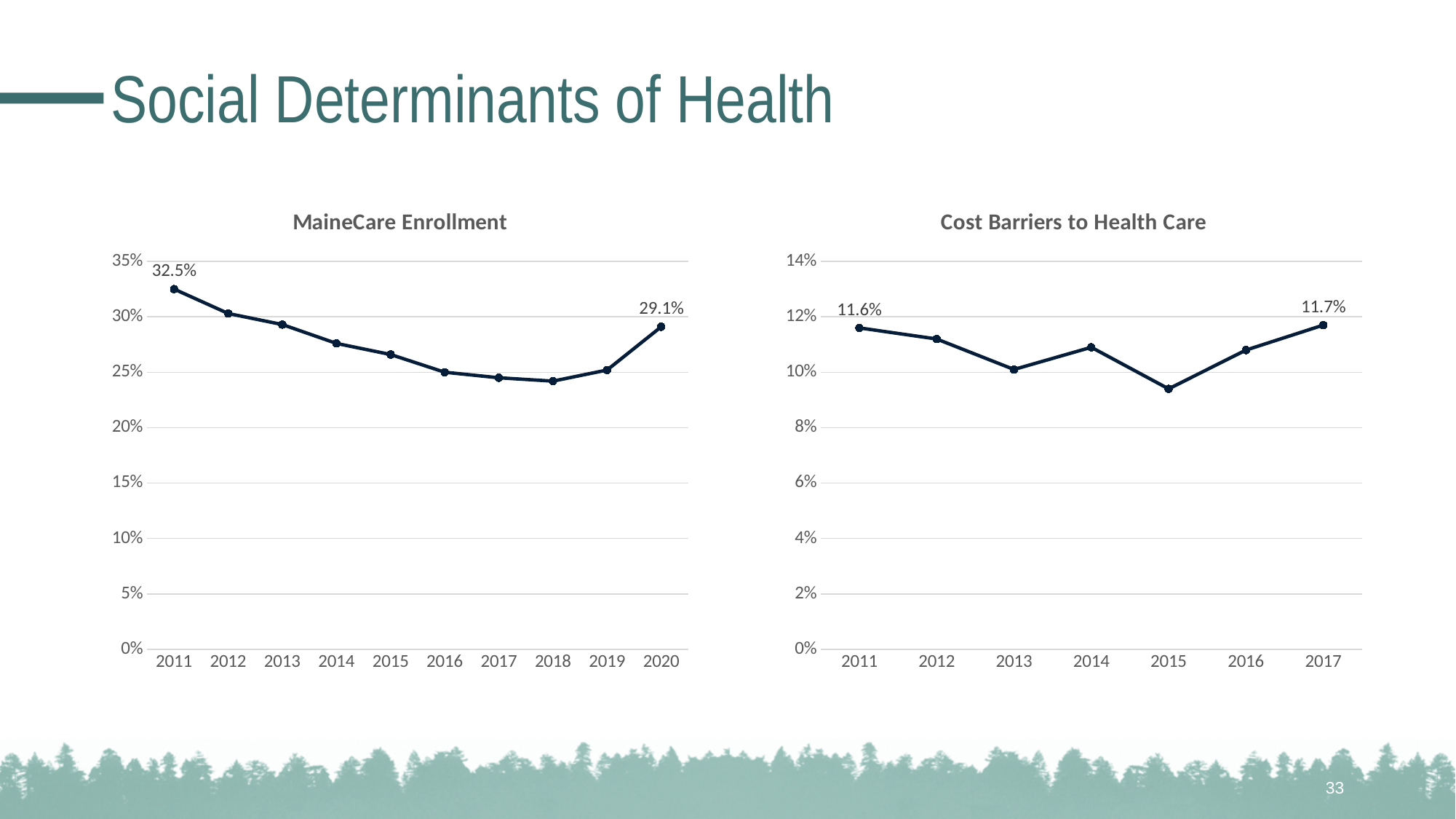
In the Cost Barriers to Health Care chart, what is the value for 2017? 11.7% In the MaineCare Enrollment chart, what is the value for 2011? 32.5% What kind of chart is the MaineCare Enrollment chart? Line chart In the MaineCare Enrollment chart, what is the difference between the 2011 value and the 2020 value? 3.4 percentage points In the Cost Barriers to Health Care chart, which year has the lowest value? 2015 In the MaineCare Enrollment chart, is the value for 2018 greater or less than 25%? less In the Cost Barriers to Health Care chart, what is the value for 2011? 11.6% How many years are plotted in the MaineCare Enrollment chart? 10 In the Cost Barriers to Health Care chart, is the value for 2015 greater or less than 10%? less In the MaineCare Enrollment chart, which year has the highest value? 2011 In the MaineCare Enrollment chart, what is the value for 2020? 29.1% How many years are plotted in the Cost Barriers to Health Care chart? 7